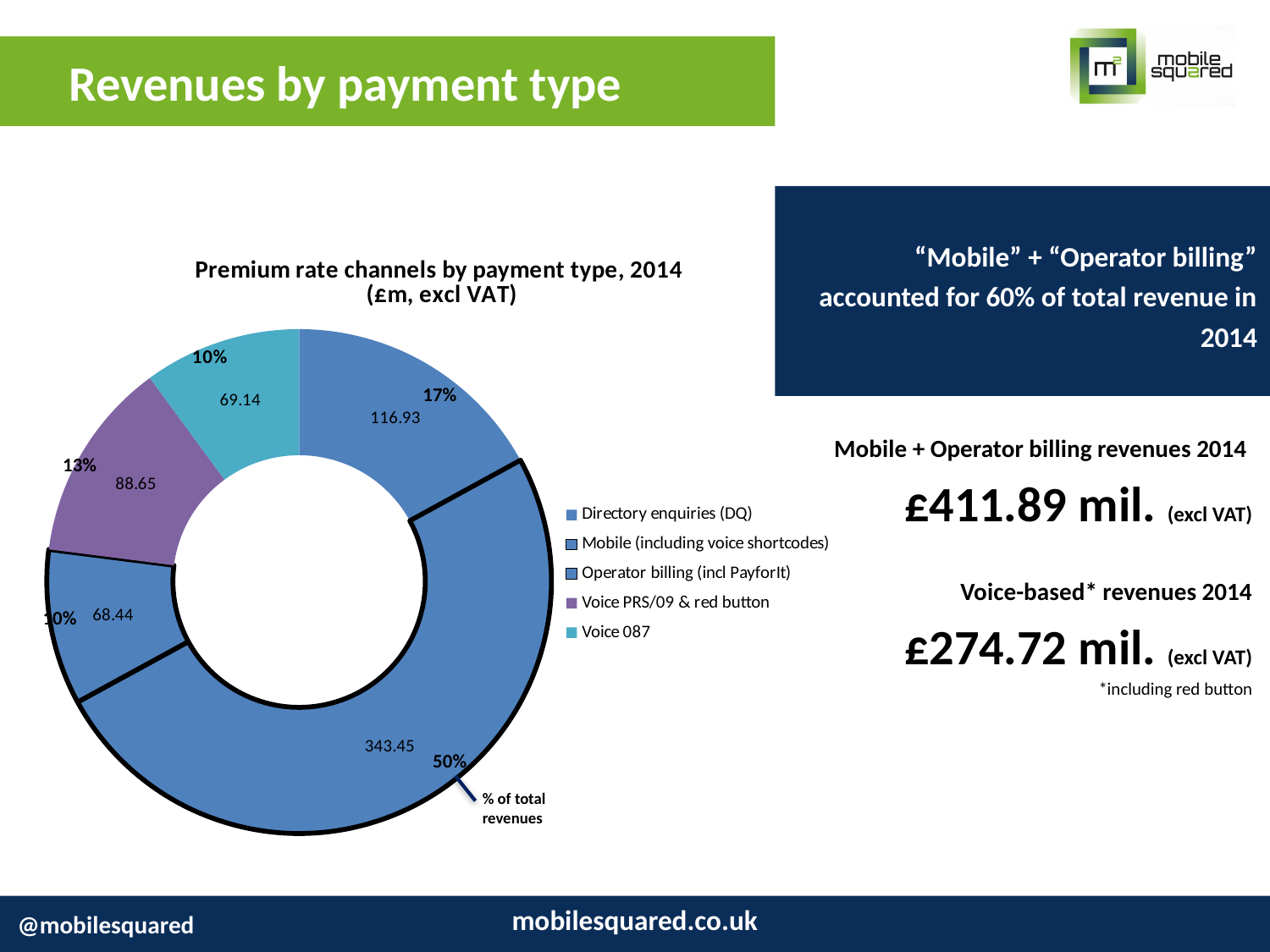
How many series does the chart legend list? 5 What is the value of the purple slice (Voice PRS/09 & red button)? 88.65 What kind of chart is shown on the slide? Doughnut (pie) chart What is the title of the chart? Premium rate channels by payment type, 2014 (£m, excl VAT) What is the smallest value labelled on the chart? 68.44 Which is larger, the Voice PRS/09 & red button slice (88.65) or the Voice 087 slice (69.14)? Voice PRS/09 & red button What is the value of the teal slice (Voice 087)? 69.14 What is the difference between the slice valued 116.93 and the slice valued 88.65? 28.28 What share of total revenues does the largest slice represent? 50% How many slices does the doughnut chart have? 5 What is the value of the largest slice in the chart? 343.45 What share of total revenues does the teal slice (Voice 087) represent? 10%